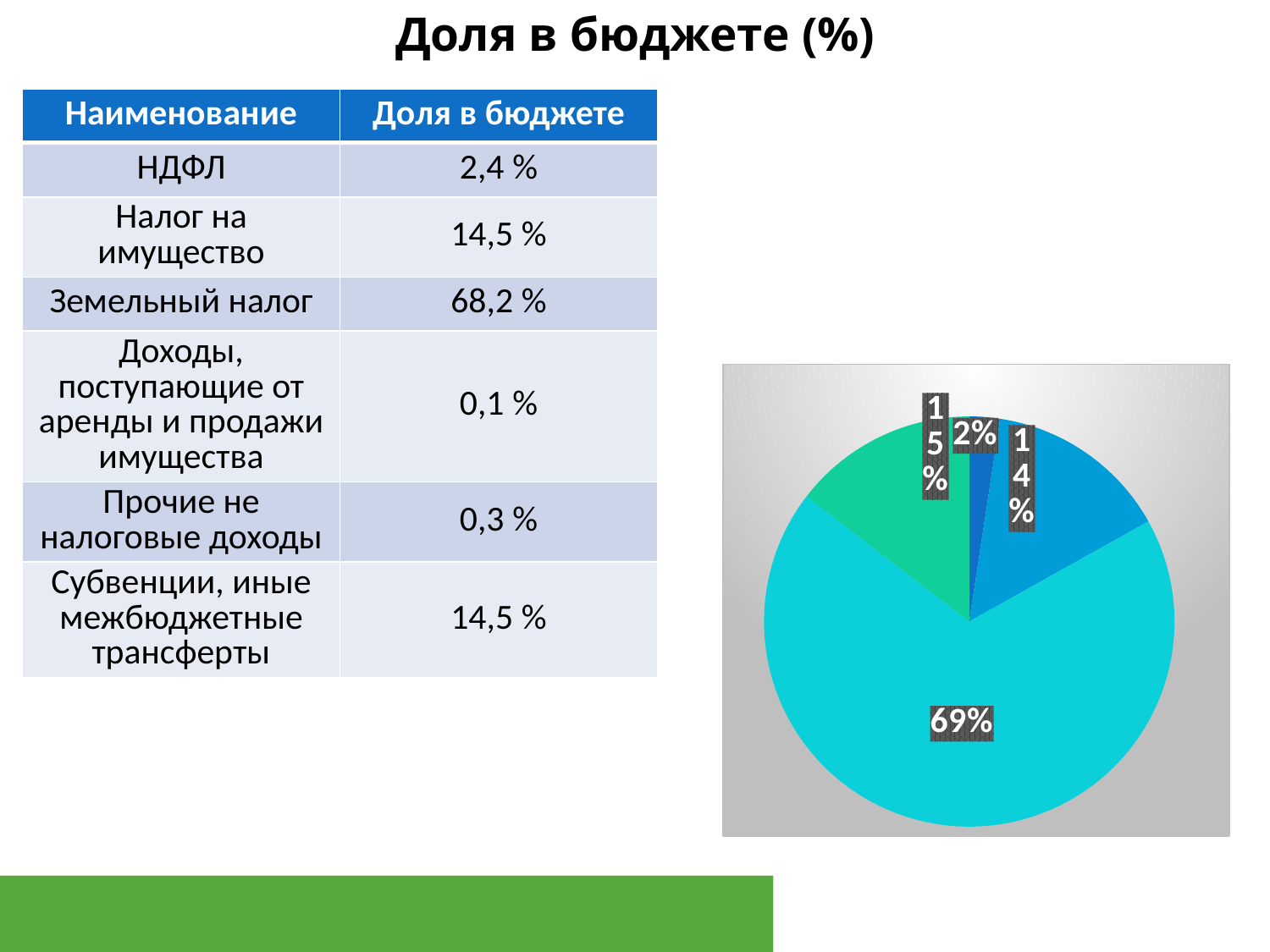
What is the difference in percentage points between the 69% slice and the 15% slice in the pie chart? 54 What is the title shown above the slide content? Доля в бюджете (%) How many labelled slices does the pie chart have? 4 What is the difference in percentage points between the 15% slice and the 14% slice in the pie chart? 1 What kind of chart is shown on the slide? pie chart Does the largest slice of the pie chart account for more or less than half of the pie? more Which slice is larger in the pie chart, the one labelled 69% or the one labelled 2%? 69% What is the data label of the dark blue slice in the pie chart? 2% What colour is the largest (69%) slice of the pie chart? cyan What is the data label of the largest slice in the pie chart? 69% What is the data label of the smallest labelled slice in the pie chart? 2% Which slice is larger in the pie chart, the one labelled 15% or the one labelled 14%? 15%